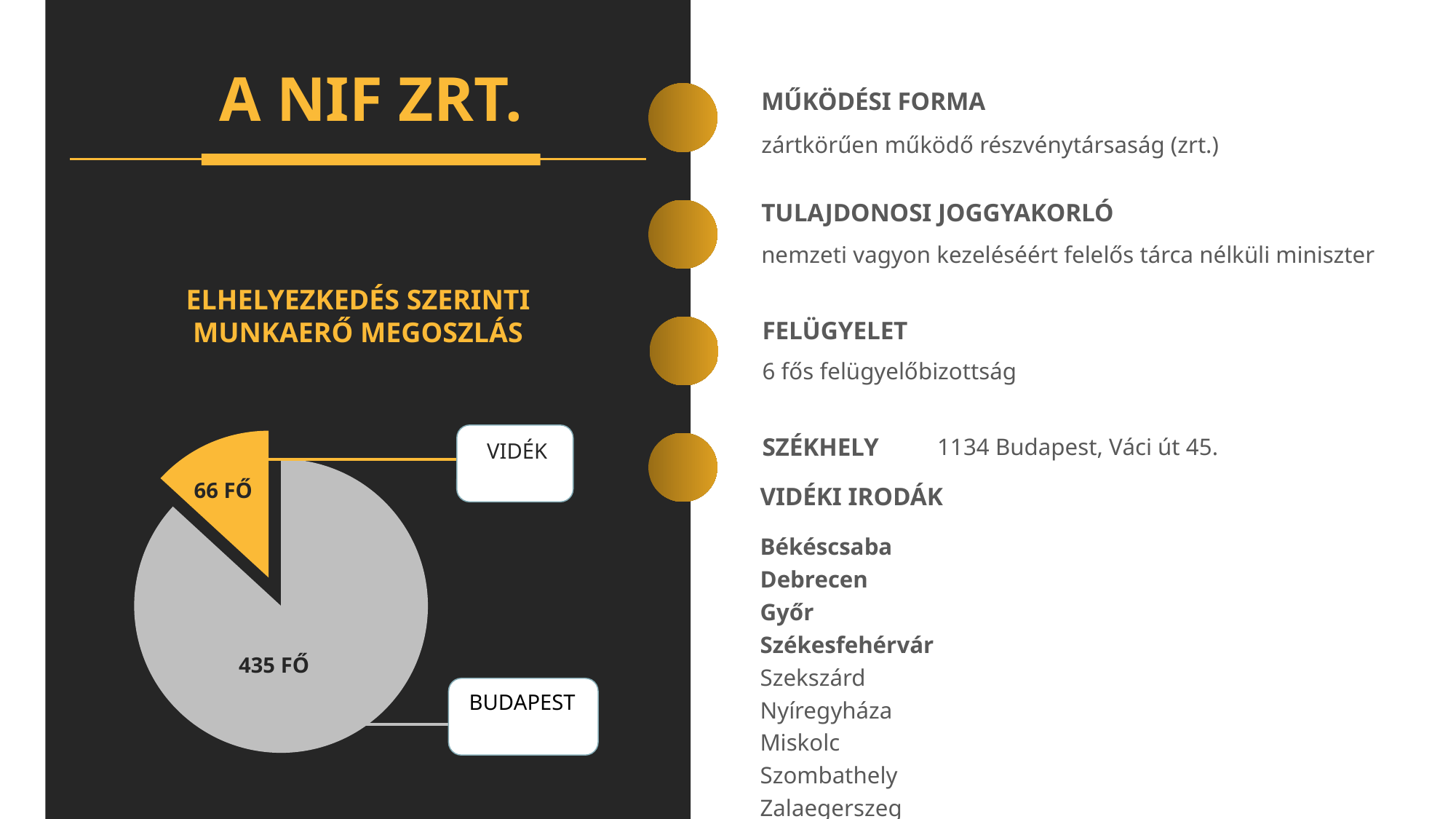
What is the value shown for the VIDÉK slice of the pie chart? 66 FŐ What is the total of the two slices in the pie chart? 501 FŐ Which slice of the pie chart is the largest? BUDAPEST What colour is the VIDÉK slice of the pie chart? yellow How many slices does the pie chart have? 2 What kind of chart is shown on the slide? pie chart Which slice of the pie chart is the smallest? VIDÉK What is the value shown for the BUDAPEST slice of the pie chart? 435 FŐ What is the title of the pie chart? ELHELYEZKEDÉS SZERINTI MUNKAERŐ MEGOSZLÁS What is the difference between the BUDAPEST and VIDÉK values in the pie chart? 369 FŐ Which is larger in the pie chart, BUDAPEST or VIDÉK? BUDAPEST